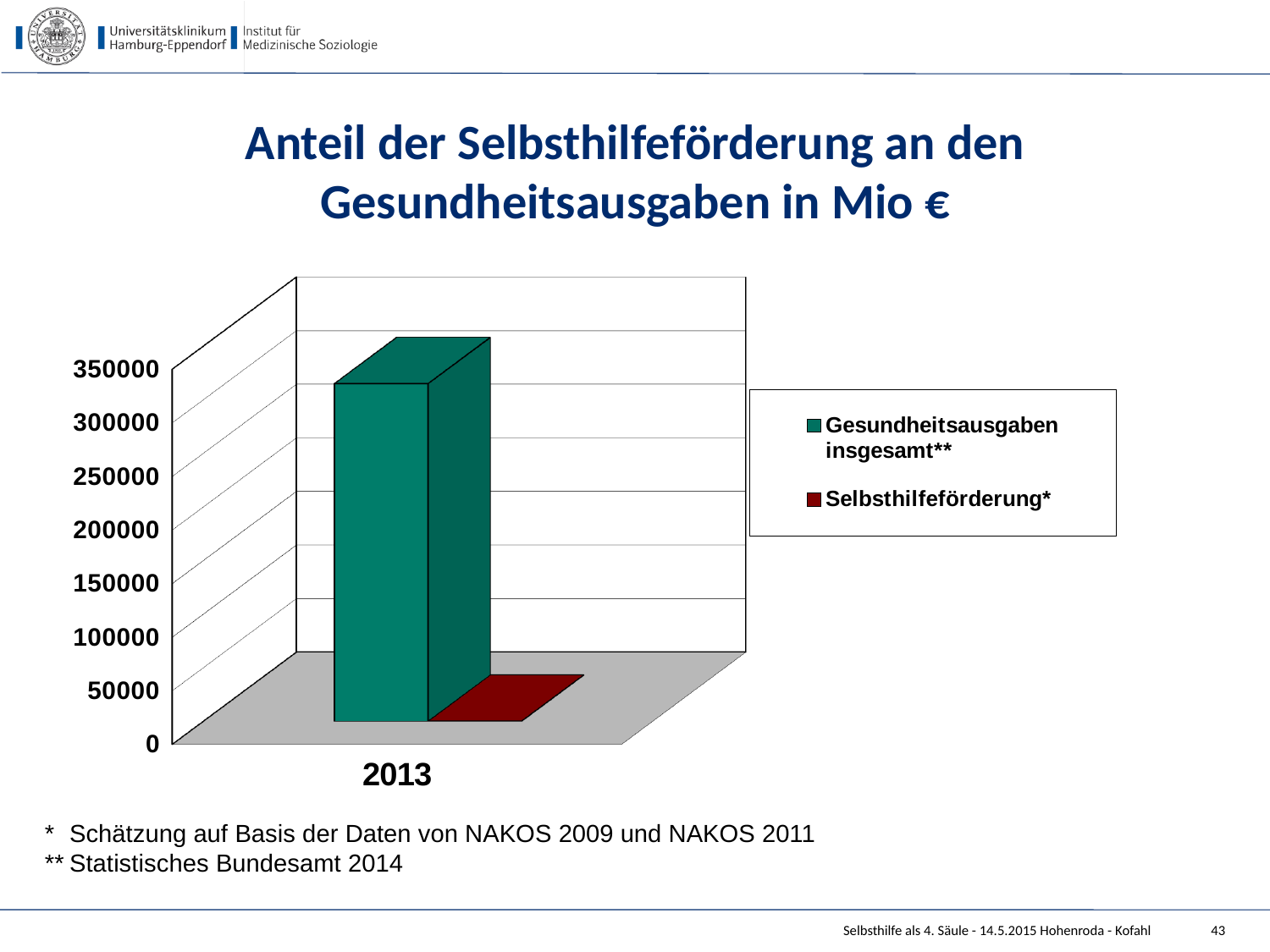
Is the value for Gesundheitsausgaben insgesamt** in 2013 greater or less than 250000? greater How many series does the legend list? 2 Which is larger in 2013: Gesundheitsausgaben insgesamt** or Selbsthilfeförderung*? Gesundheitsausgaben insgesamt** What is the highest value shown on the vertical axis? 350000 Which series has the lowest value in 2013? Selbsthilfeförderung* How many categories are shown on the x axis? 1 What kind of chart is shown on the slide? bar chart Which series has the highest value in 2013? Gesundheitsausgaben insgesamt** Which year is shown on the x axis? 2013 What is the title of the chart? Anteil der Selbsthilfeförderung an den Gesundheitsausgaben in Mio € Is the value for Selbsthilfeförderung* in 2013 greater or less than 50000? less